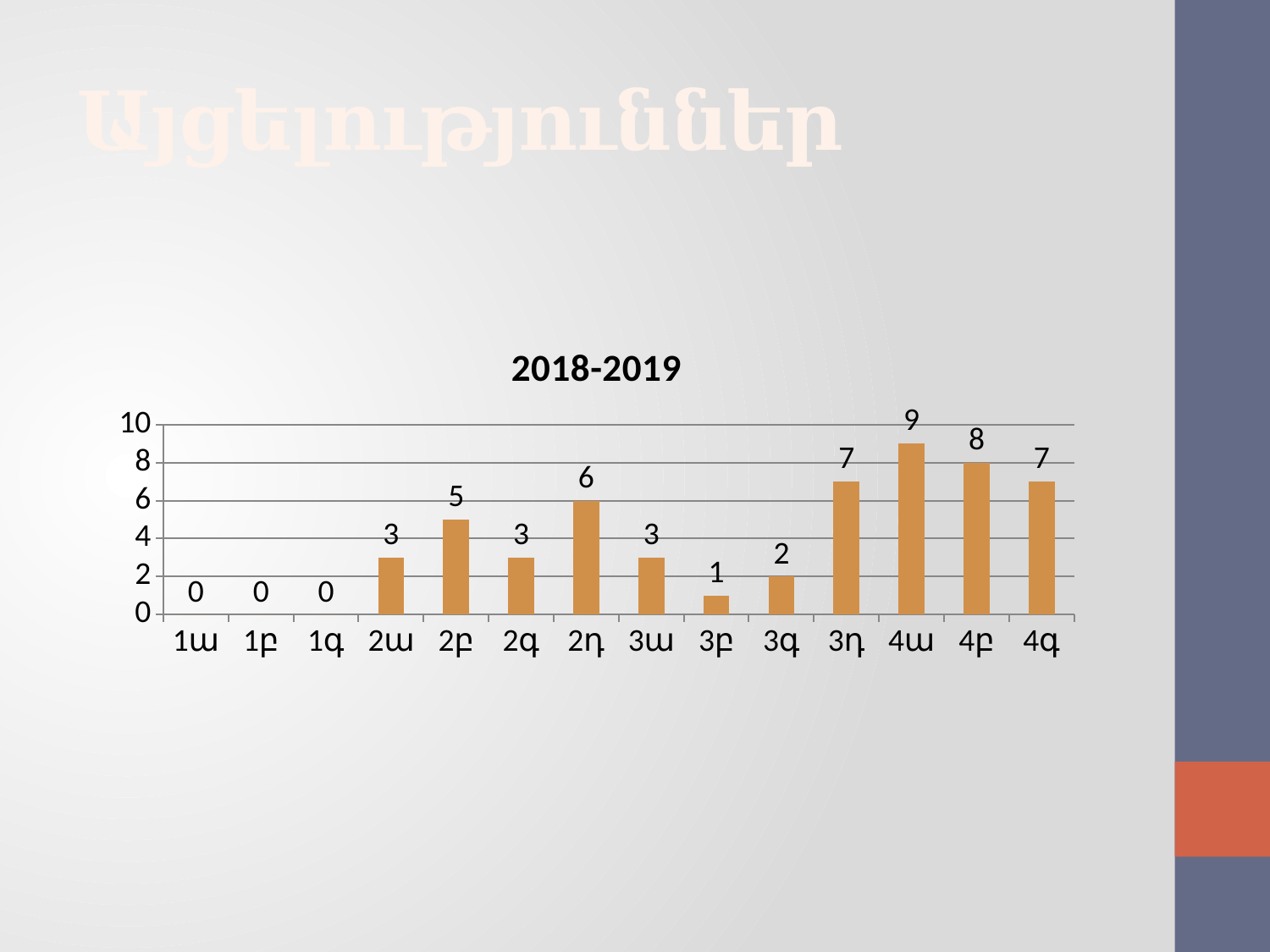
How many categories are shown on the x axis of the chart? 14 What is the value for 4ա in the chart? 9 What kind of chart is shown on the slide? bar chart What is the value for 2դ in the chart? 6 What is the difference between the values for 4բ and 2բ? 3 Which category has the highest value in the chart? 4ա Which is larger, the value for 3դ or the value for 2դ? 3դ How many categories in the chart have a value of 0? 3 What is the difference between the values for 4ա and 3գ? 7 What is the value for 3բ in the chart? 1 Which is larger, the value for 2բ or the value for 3գ? 2բ What is the title of the chart? 2018-2019